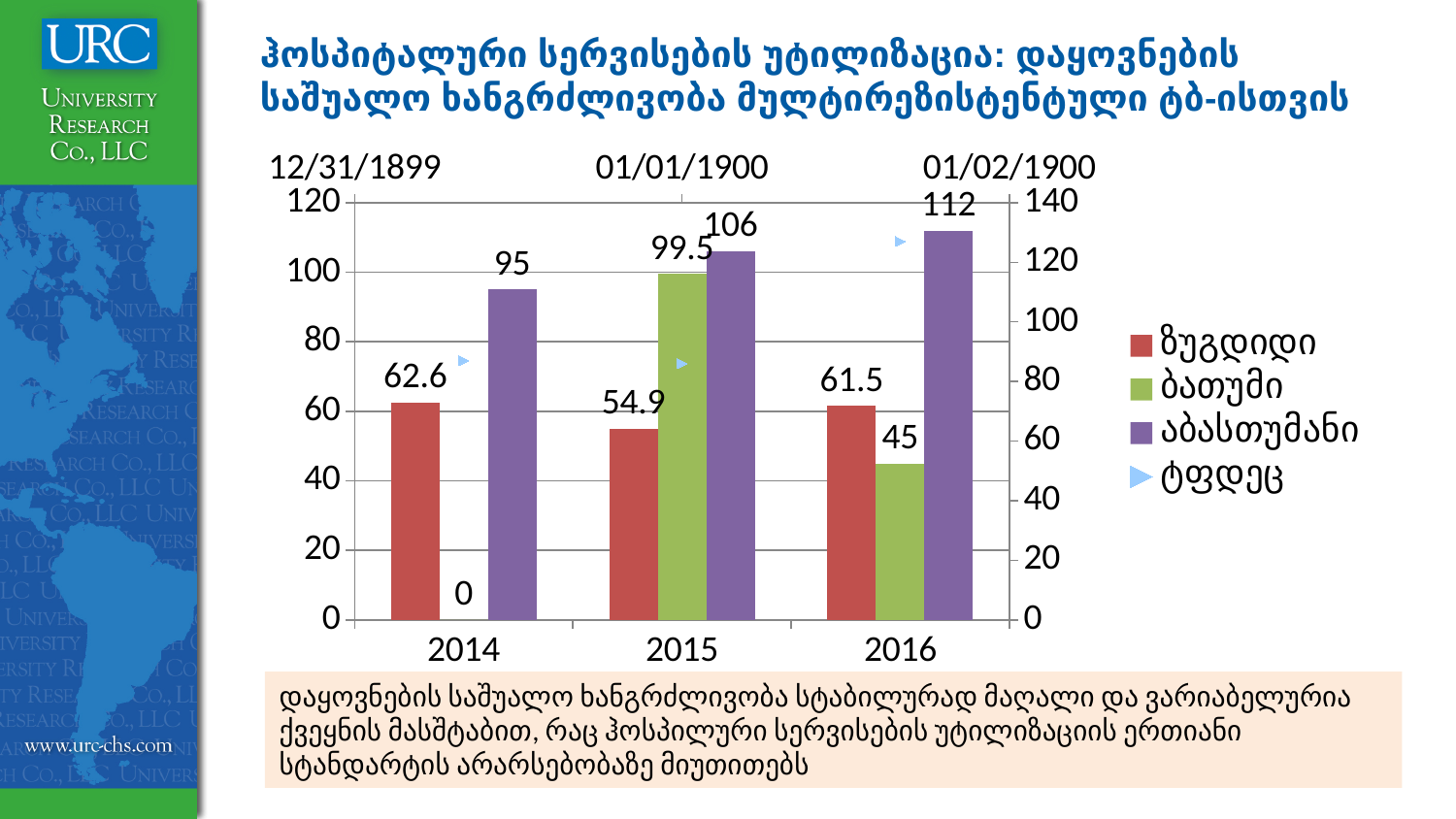
What is the value for ზუგდიდი in 2014? 62.6 Do the values for აბასთუმანი rise or fall from 2014 to 2016? rise What is the value for ბათუმი in 2014? 0 How many years are shown on the x axis? 3 What is the value for აბასთუმანი in 2016? 112 What is the difference between the აბასთუმანი and ზუგდიდი values in 2016? 50.5 In which year is the value for ზუგდიდი lowest? 2015 In which year is the value for აბასთუმანი highest? 2016 What is the value for ბათუმი in 2015? 99.5 What kind of chart is shown on the slide? bar chart How many series does the legend list? 4 Which is larger in 2015: the value for ბათუმი or the value for ზუგდიდი? ბათუმი